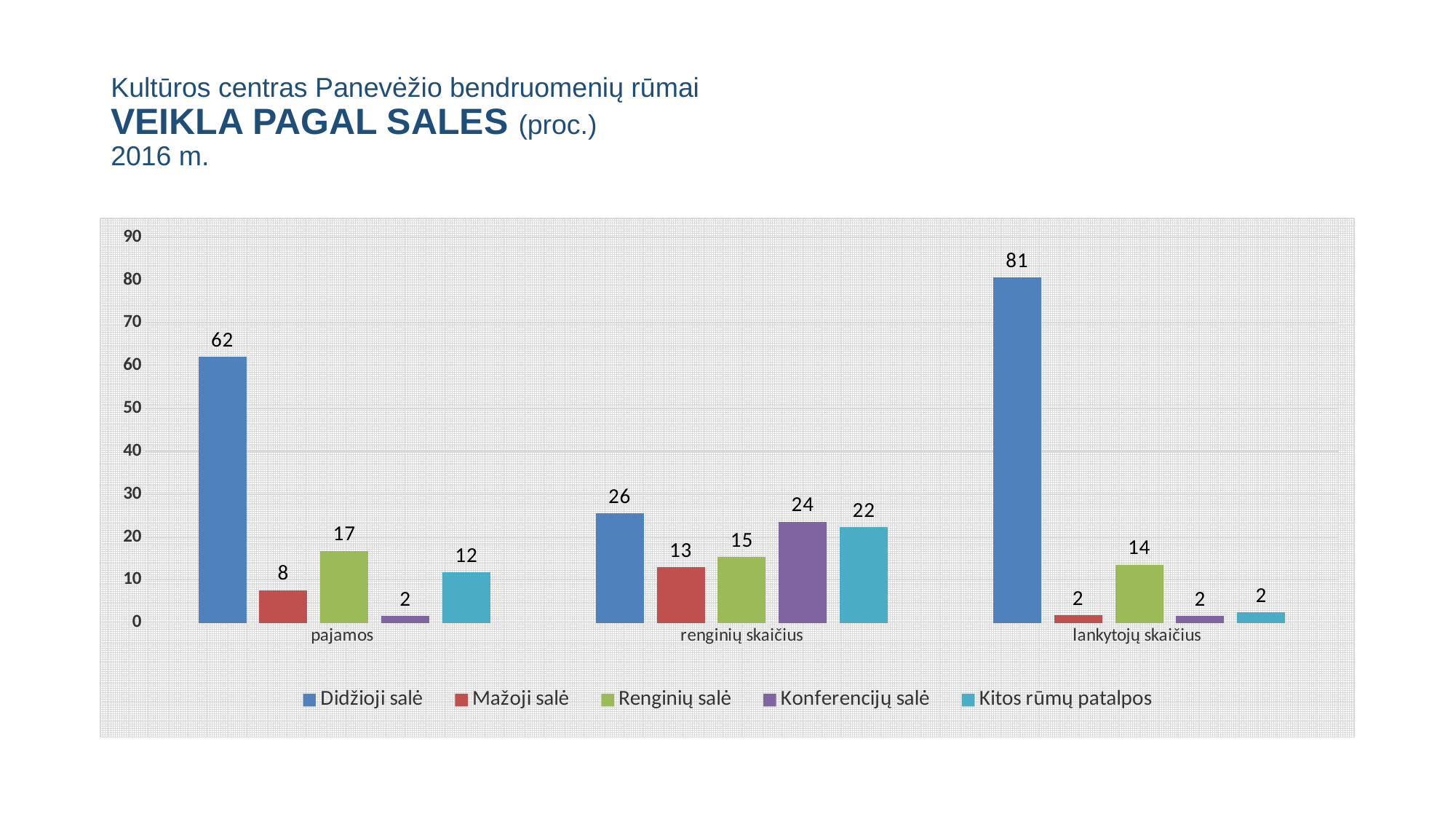
How many categories are shown on the x axis? 3 What kind of chart is shown on the slide? bar chart Which is larger in the renginių skaičius category: Renginių salė or Kitos rūmų patalpos? Kitos rūmų patalpos Which series has the lowest value in the renginių skaičius category? Mažoji salė What is the value for Didžioji salė in the pajamos category? 62 How many series does the legend list? 5 What is the value for Renginių salė in the lankytojų skaičius category? 14 Which series has the highest value in the lankytojų skaičius category? Didžioji salė What colour represents Kitos rūmų patalpos in the chart? teal (light blue) What is the value for Konferencijų salė in the renginių skaičius category? 24 What is the difference between the Didžioji salė values for lankytojų skaičius and pajamos? 19 Is the value for Didžioji salė in the lankytojų skaičius category greater or less than 70? greater